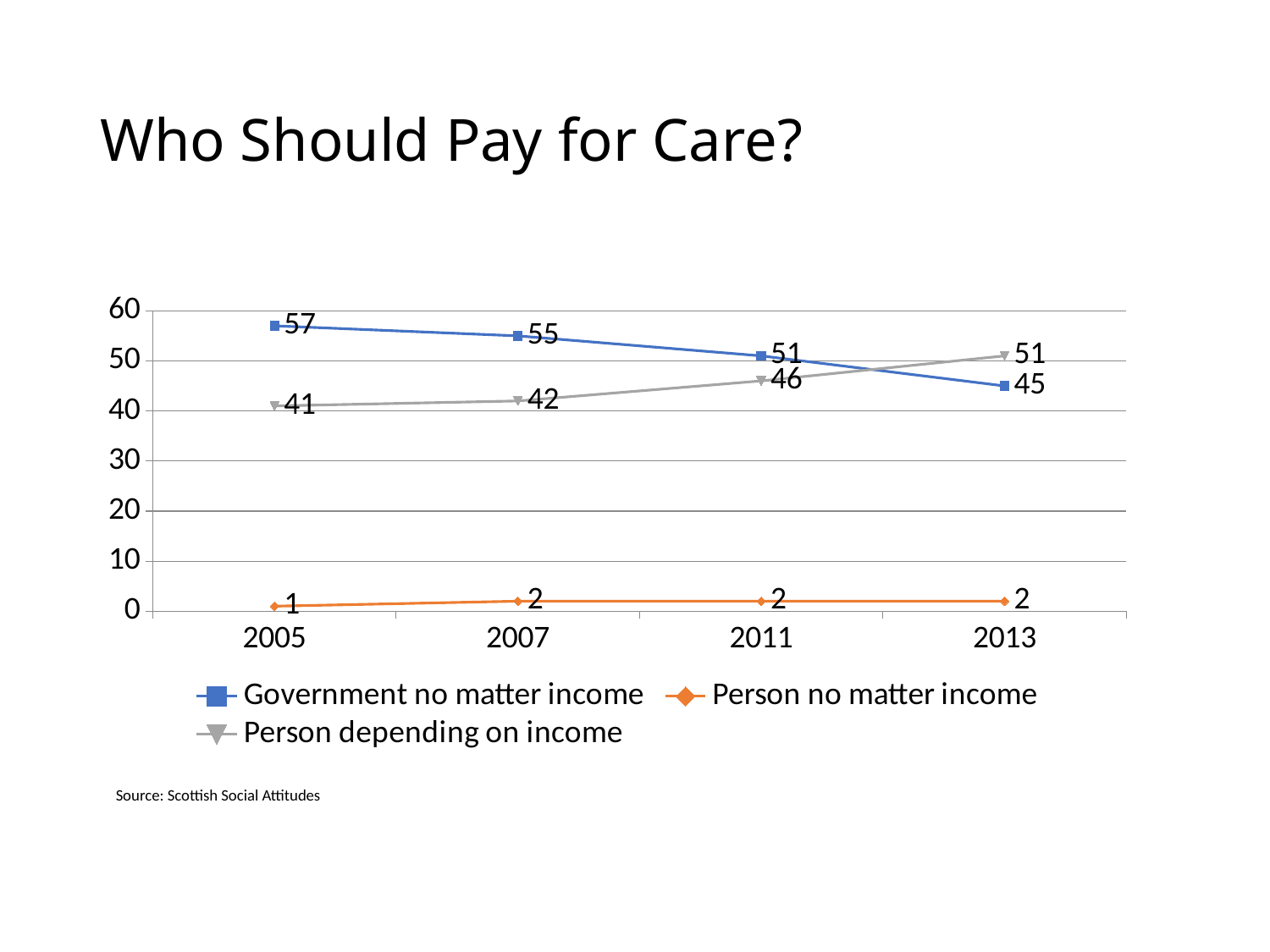
In which year is Person depending on income highest? 2013 What is the difference between Government no matter income and Person depending on income in 2005? 16 What is the value for Person depending on income in 2013? 51 What is the value for Person no matter income in 2005? 1 What kind of chart is shown? Line chart How many series does the legend list? 3 How many years are shown on the x axis? 4 In which year is Government no matter income lowest? 2013 What is the value for Government no matter income in 2005? 57 Does Government no matter income rise or fall from 2005 to 2013? Fall Which is larger in 2013: Government no matter income or Person depending on income? Person depending on income What is the title of the chart? Who Should Pay for Care?